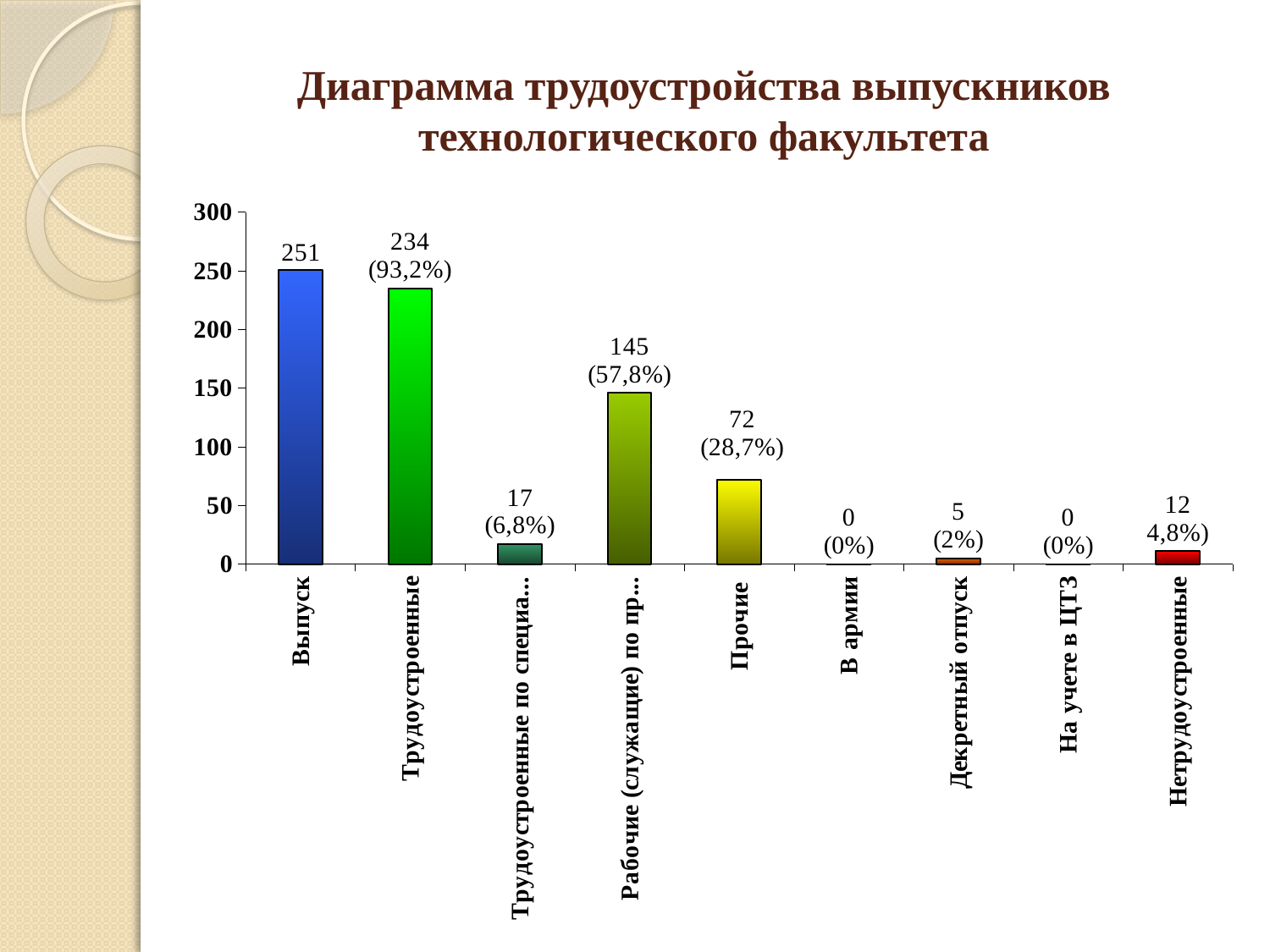
What kind of chart is shown on the slide? bar chart What is the value for Трудоустроенные? 234 Which is larger, the value for Прочие or the value for Нетрудоустроенные? Прочие What is the value for Нетрудоустроенные? 12 What percentage is shown for Трудоустроенные? 93,2% Is the value for Прочие greater or less than 100? less What is the value for Декретный отпуск? 5 What is the value for Прочие? 72 Which category has the highest value? Выпуск What is the value for Выпуск? 251 How many categories are shown on the x axis? 9 What is the difference between the values for Выпуск and Трудоустроенные? 17